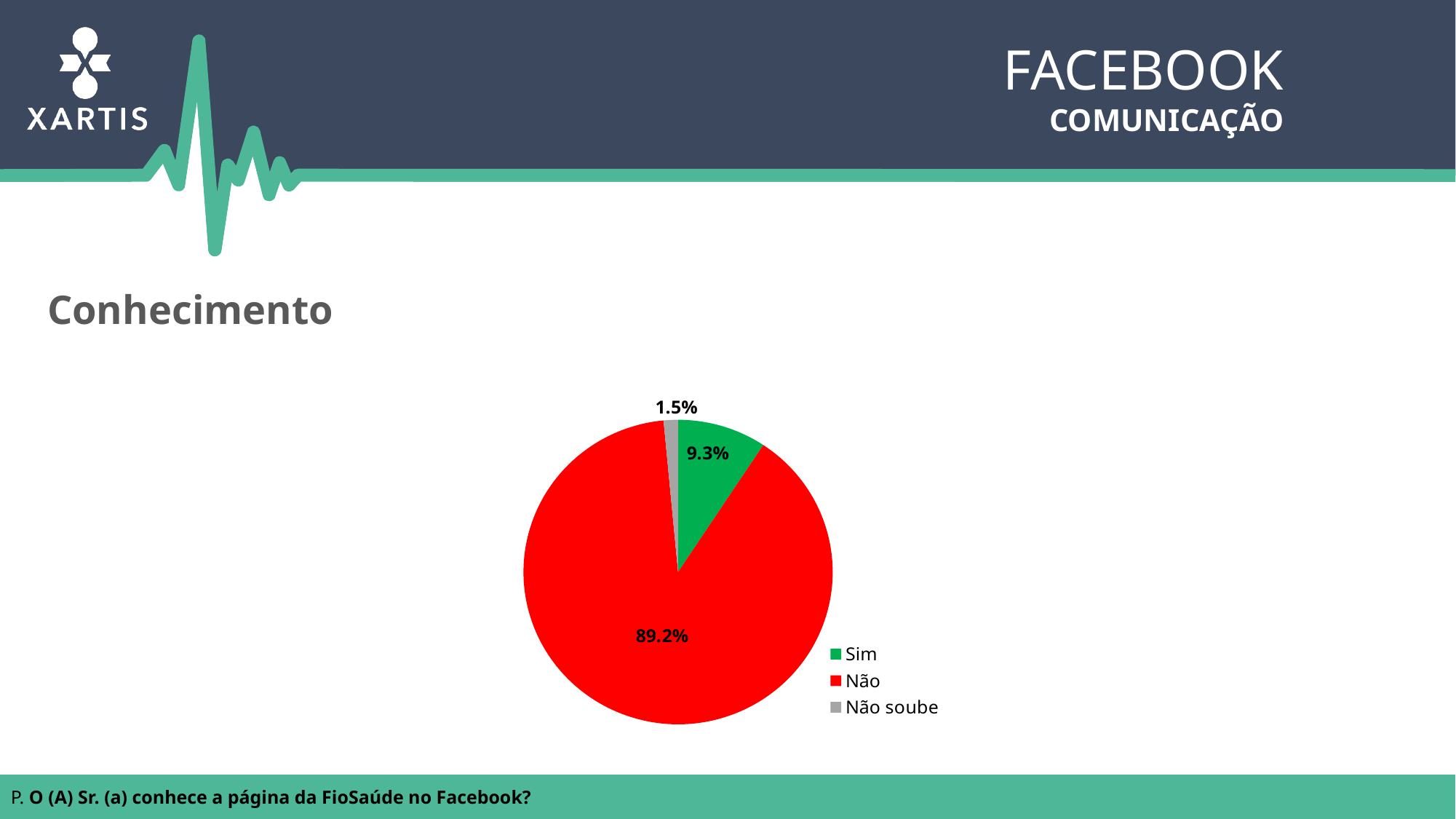
Which category has the largest slice of the pie? Não What is the difference in percentage points between "Não" and "Sim"? 79.9 What is the heading above the chart? Conhecimento What percentage of respondents answered "Não"? 89.2% What colour is the "Não" slice? red What percentage of respondents answered "Não soube"? 1.5% How many categories does the legend list? 3 Which is larger, the share for "Sim" or the share for "Não soube"? Sim Which category has the smallest slice of the pie? Não soube What percentage of respondents answered "Sim"? 9.3% What is the combined share of "Sim" and "Não soube"? 10.8% What kind of chart is shown on the slide? pie chart